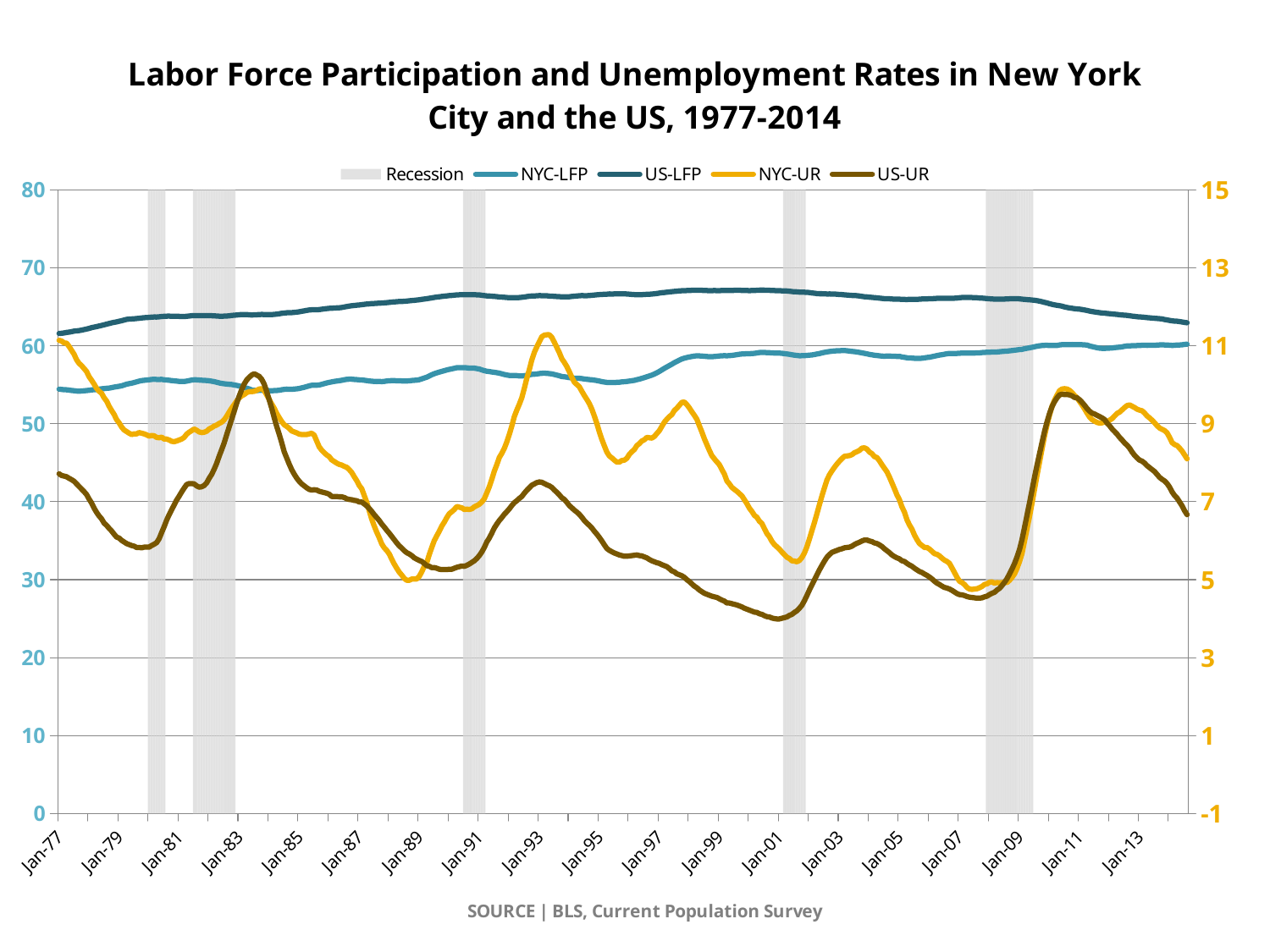
Does the US-LFP series rise or fall from Jan-09 to the end of the chart? fall At Jan-01, which series is higher: NYC-UR or US-UR? NYC-UR Does the NYC-LFP series generally rise or fall from Jan-77 to Jan-13? rise Is the value for US-LFP at Jan-77 greater or less than 60 on the left axis? greater What kind of chart is shown on the slide? line chart Is the value for US-UR at Jan-01 greater or less than 5 on the right axis? less How many shaded recession periods are marked on the chart? 5 Is the value for NYC-LFP at Jan-77 greater or less than 60 on the left axis? less What is the title of the chart? Labor Force Participation and Unemployment Rates in New York City and the US, 1977-2014 At Jan-77, which series is higher: US-LFP or NYC-LFP? US-LFP How many entries does the chart legend list? 5